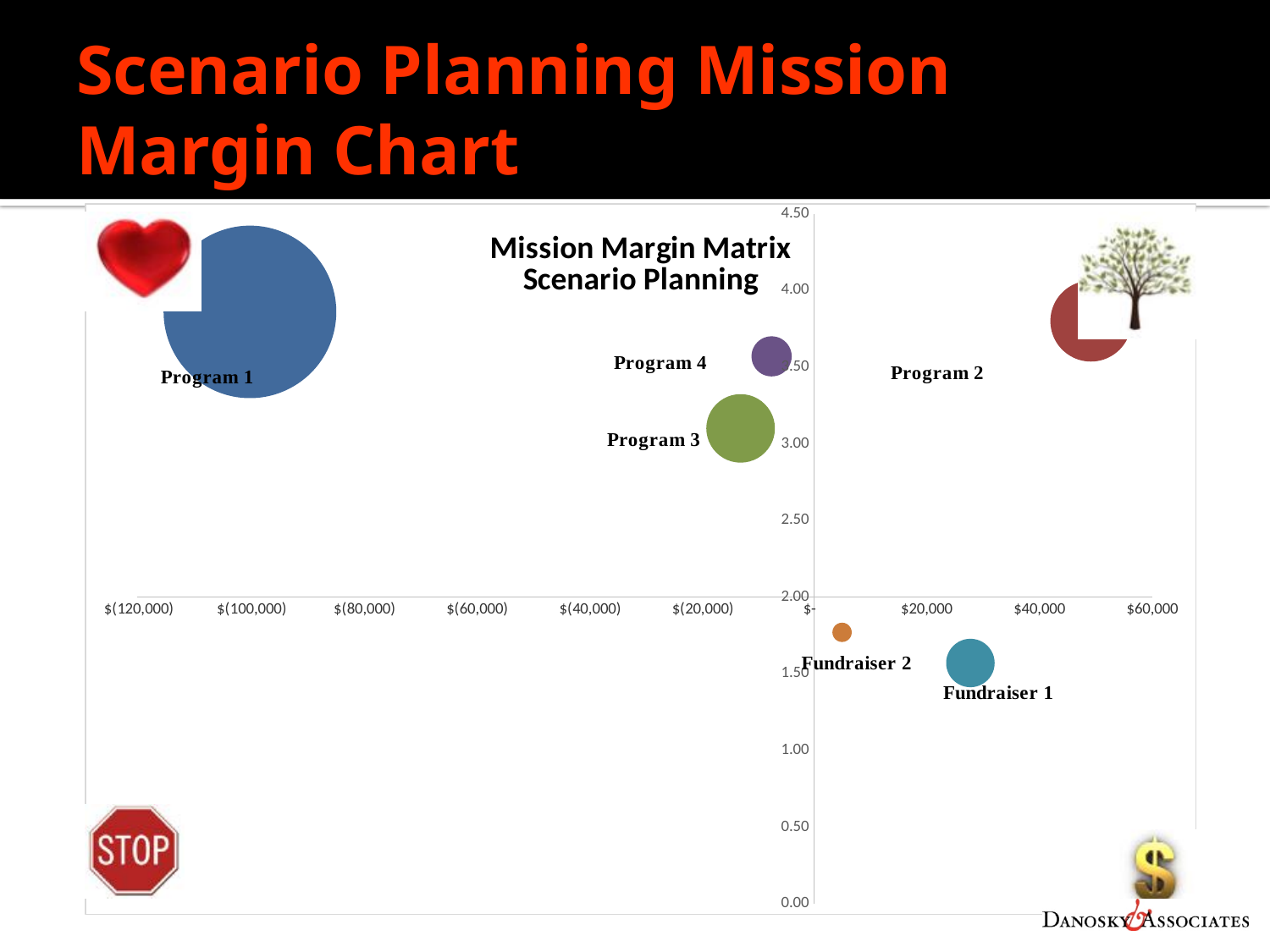
How many bubbles are plotted on the chart? 6 Is the vertical-axis value for Fundraiser 1 greater or less than 2.00? less Is the horizontal-axis value for Fundraiser 2 greater or less than $20,000? less Which has the larger horizontal-axis value, Program 1 or Program 2? Program 2 Is the horizontal-axis value for Program 1 greater or less than $(80,000)? less What is the title of the chart? Mission Margin Matrix Scenario Planning What kind of chart is shown on the slide? bubble chart Which bubble is furthest to the left on the horizontal axis? Program 1 Which bubble is the largest in size? Program 1 Which is positioned higher on the vertical axis, Program 3 or Program 4? Program 4